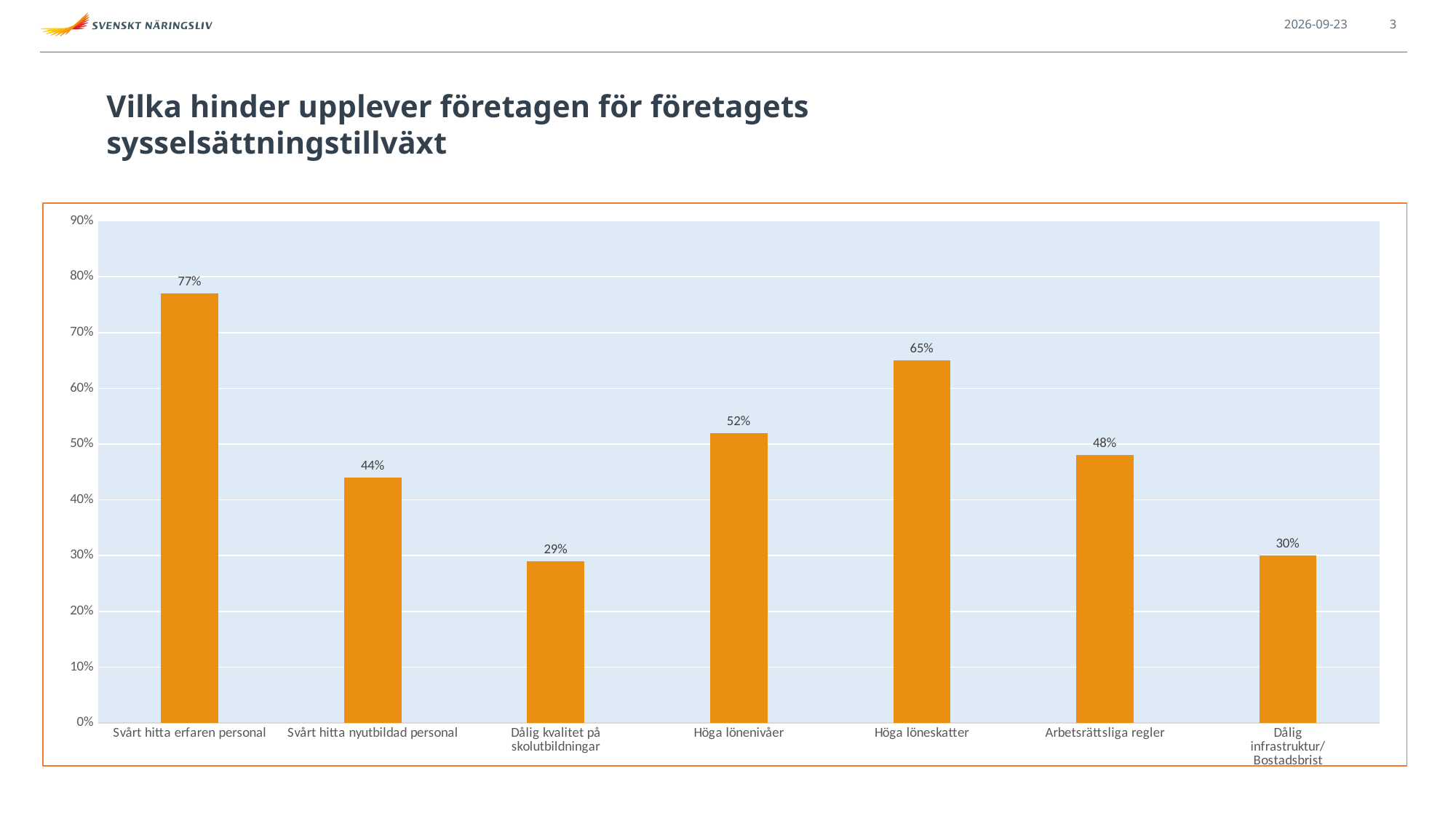
Is the value for Höga löneskatter greater or less than 60%? greater Which is larger, Höga lönenivåer or Arbetsrättsliga regler? Höga lönenivåer What is the value for Arbetsrättsliga regler? 48% Which category has the lowest value? Dålig kvalitet på skolutbildningar What is the value for Svårt hitta erfaren personal? 77% What colour are the bars in the chart? Orange What is the value for Dålig infrastruktur/Bostadsbrist? 30% Which category has the highest value? Svårt hitta erfaren personal How many categories are shown in the chart? 7 What is the value for Höga löneskatter? 65% What kind of chart is shown on the slide? Bar chart What is the difference between Svårt hitta erfaren personal and Svårt hitta nyutbildad personal? 33 percentage points